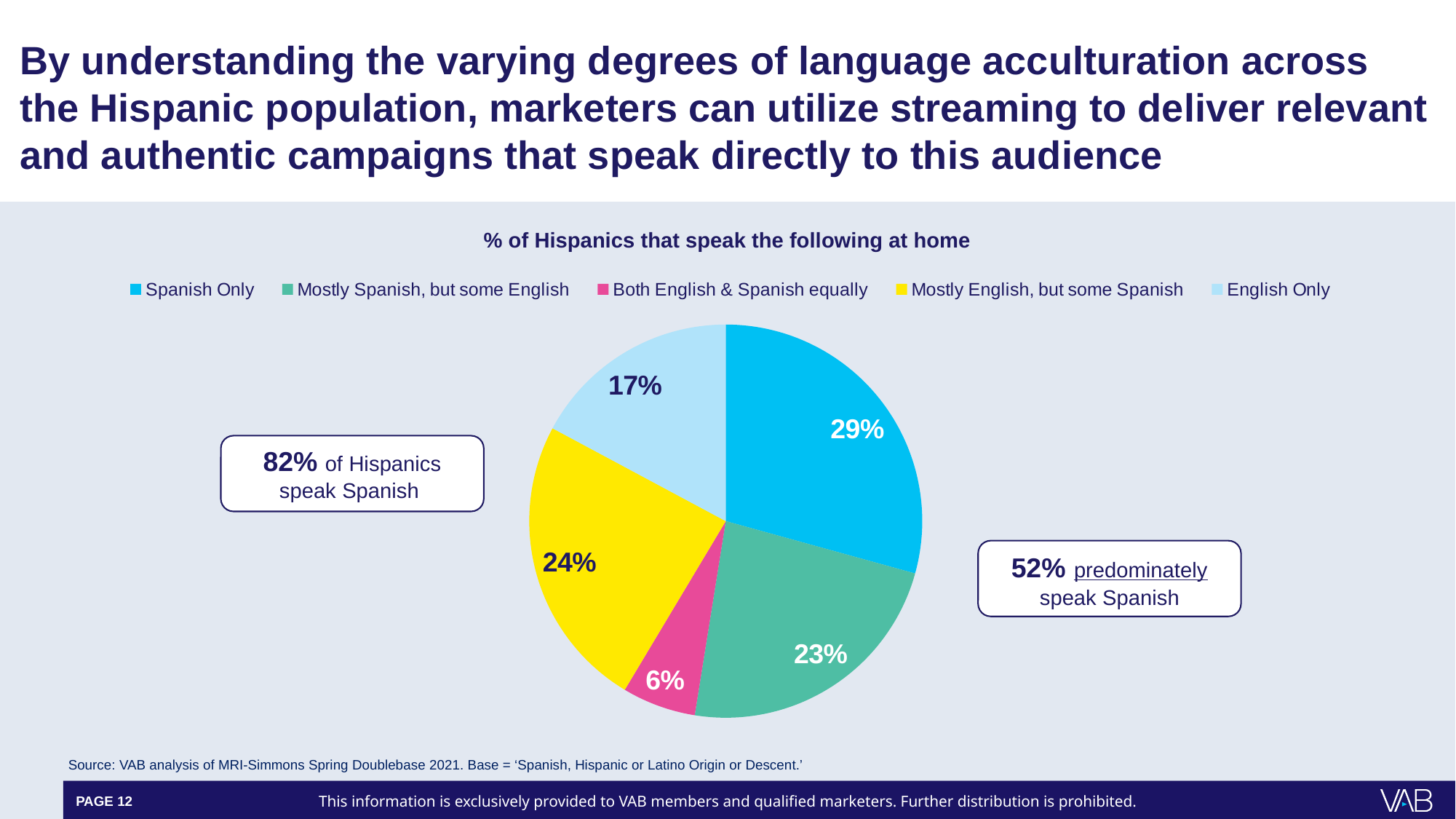
Which category has the smallest share of the pie? Both English & Spanish equally What percentage of Hispanics speak Both English & Spanish equally at home? 6% What percentage of Hispanics speak Spanish Only at home? 29% Which category has the largest share of the pie? Spanish Only What percentage of Hispanics speak English Only at home? 17% What is the title of the chart? % of Hispanics that speak the following at home How many categories does the pie chart show? 5 What percentage of Hispanics speak Mostly Spanish, but some English at home? 23% What percentage of Hispanics speak Mostly English, but some Spanish at home? 24% Which is larger: the share for Mostly English, but some Spanish or the share for English Only? Mostly English, but some Spanish What is the difference in percentage points between Spanish Only and English Only? 12 What type of chart is shown on the slide? Pie chart